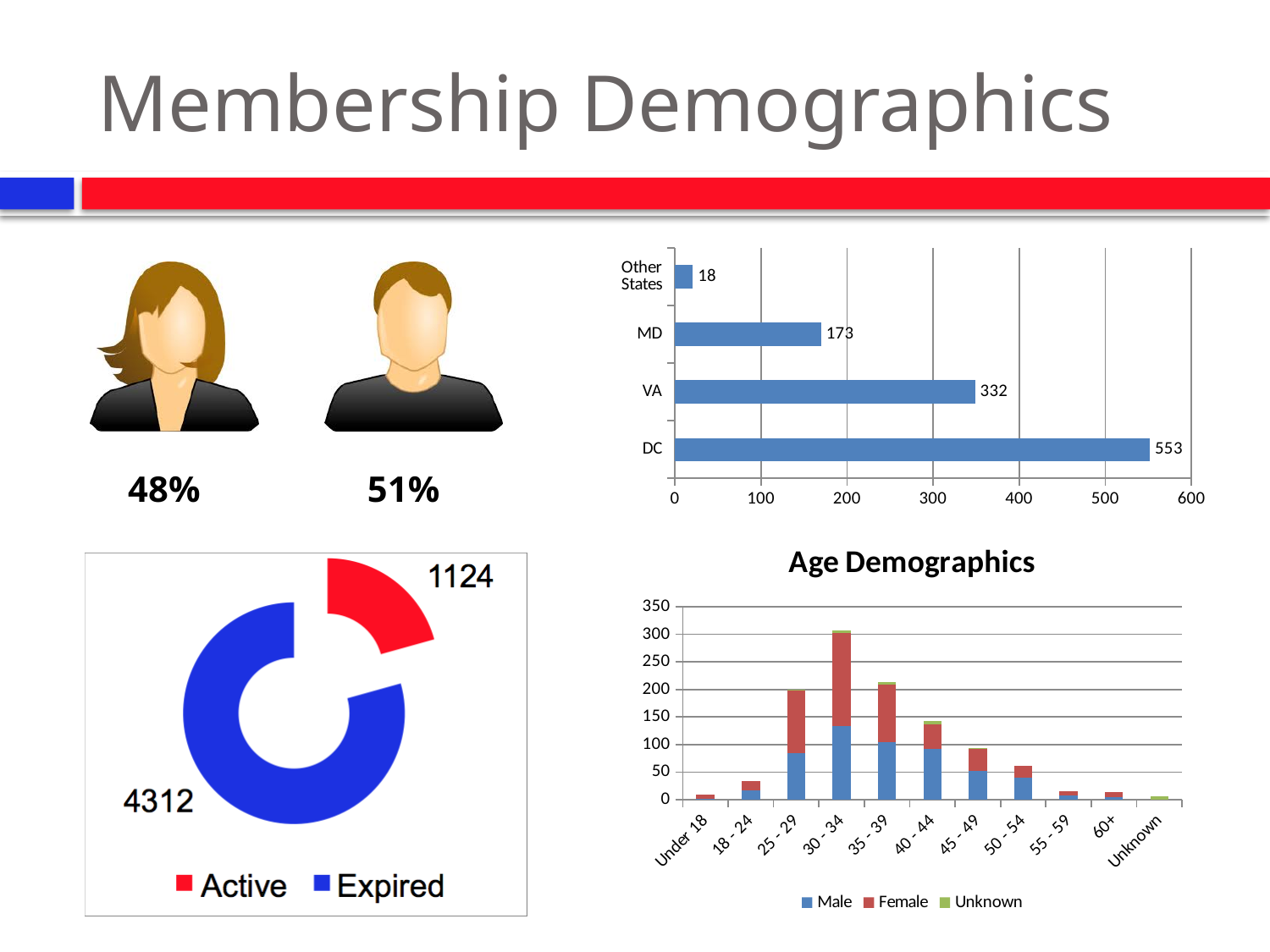
In the top-right bar chart of members by state, what is the value for MD? 173 In the top-right bar chart of members by state, what is the difference between the values for DC and VA? 221 In the Age Demographics chart, which age group has the highest total? 30 - 34 In the top-right bar chart of members by state, which category has the lowest value? Other States In the top-right bar chart of members by state, how many categories are shown? 4 In the Age Demographics chart, how many series does the legend list? 3 In the bottom-left doughnut chart, what is the total of Active and Expired? 5436 In the bottom-left doughnut chart, what is the value for Expired? 4312 In the Age Demographics chart, how many age categories are shown on the x axis? 11 In the bottom-left doughnut chart, which is larger, Active or Expired? Expired In the top-right bar chart of members by state, what is the value for DC? 553 In the Age Demographics chart, is the total for 40 - 44 greater or less than 150? less